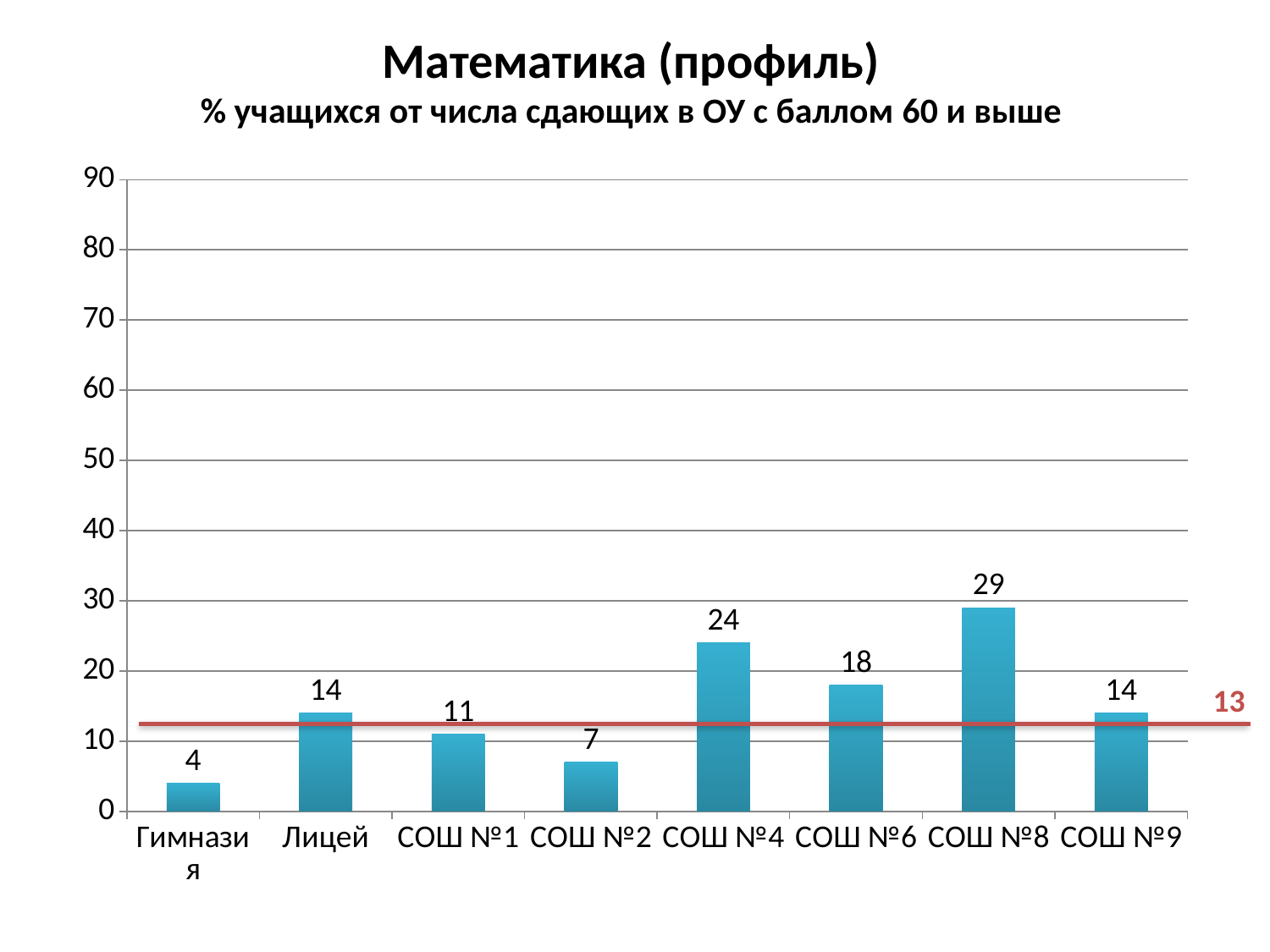
Which is larger, the value for Лицей or the value for СОШ №1? Лицей What kind of chart is this? bar chart What value is marked by the red horizontal line? 13 What is the value for Гимназия? 4 How many categories are shown on the x axis? 8 What is the value for СОШ №2? 7 What is the difference between the values for СОШ №8 and СОШ №6? 11 What is the title of the chart? Математика (профиль) What is the value for СОШ №4? 24 Which category has the highest value? СОШ №8 Which category has the lowest value? Гимназия Is the value for СОШ №4 greater or less than 20? greater